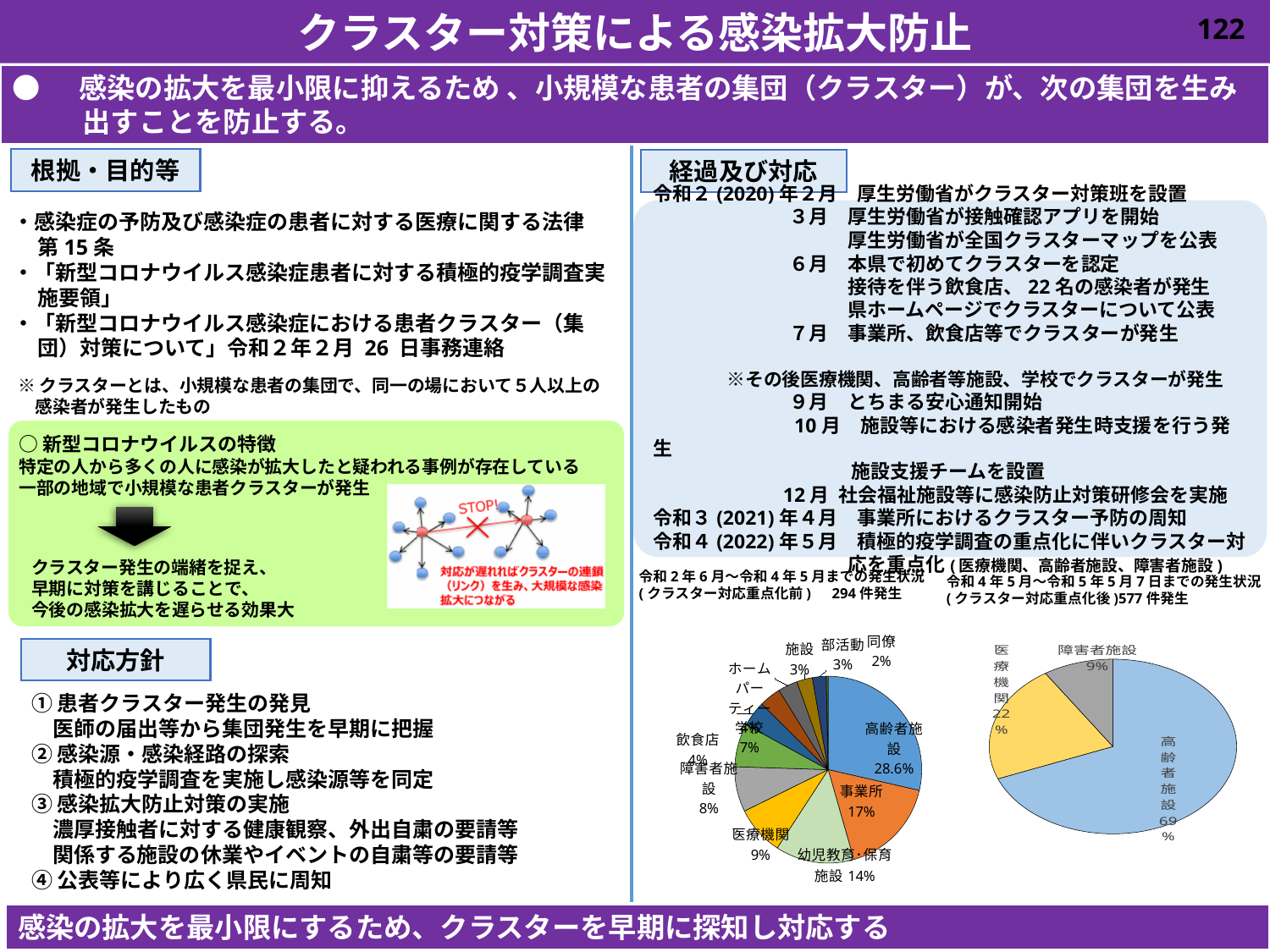
In the right pie chart (クラスター対応重点化後), which category has the largest share? 高齢者施設 In the left pie chart (クラスター対応重点化前), what share is shown for 幼児教育・保育施設? 14% What type of chart is used to show the cluster occurrence breakdowns on this slide? Pie chart In the left pie chart (クラスター対応重点化前, 294件発生), what share is shown for 高齢者施設? 28.6% In the left pie chart (クラスター対応重点化前), what share is shown for 事業所? 17% In the right pie chart (クラスター対応重点化後), how many percentage points larger is 高齢者施設 than 医療機関? 47 percentage points In the right pie chart (クラスター対応重点化後), what share is shown for 障害者施設? 9% How many slices does the right pie chart (クラスター対応重点化後) have? 3 In the left pie chart (クラスター対応重点化前), which category has the largest share? 高齢者施設 In the right pie chart (クラスター対応重点化後), which category has the smallest share? 障害者施設 In the right pie chart (クラスター対応重点化後), what share is shown for 医療機関? 22% In the right pie chart (クラスター対応重点化後, 577件発生), what share is shown for 高齢者施設? 69%